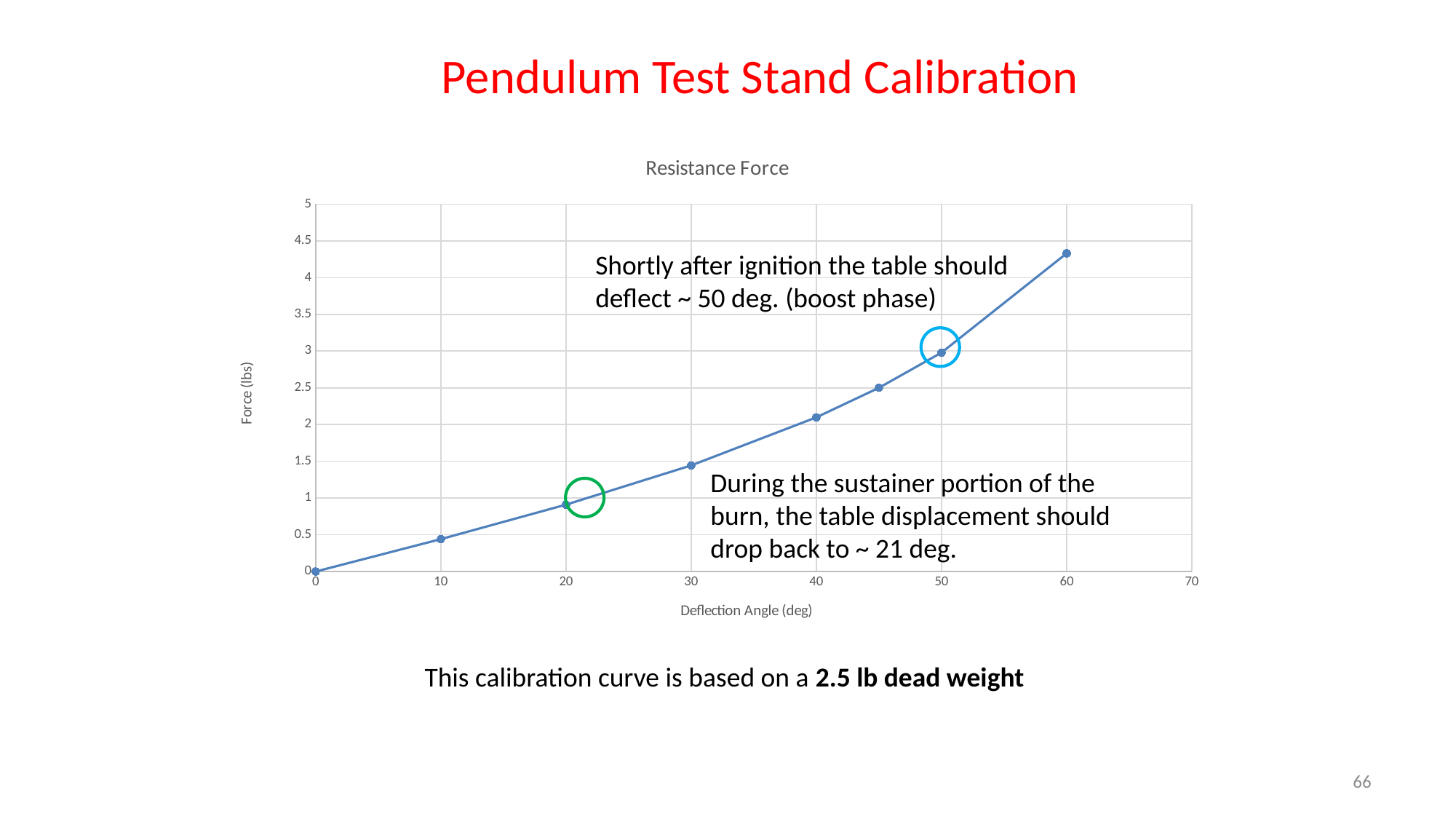
Is the force at a deflection angle of 10 degrees greater or less than 1? less At which deflection angle is the force lowest? 0 Does the force rise or fall as the deflection angle increases? rises Which has the larger force: a deflection angle of 30 degrees or 50 degrees? 50 degrees At which deflection angle is the force highest? 60 What is the title of the chart? Resistance Force What is the force at a deflection angle of 0 degrees? 0 How many data points are plotted on the chart? 8 What kind of chart is shown on the slide? line chart Is the force at a deflection angle of 60 degrees greater or less than 4? greater What is the label of the x axis of the chart? Deflection Angle (deg)